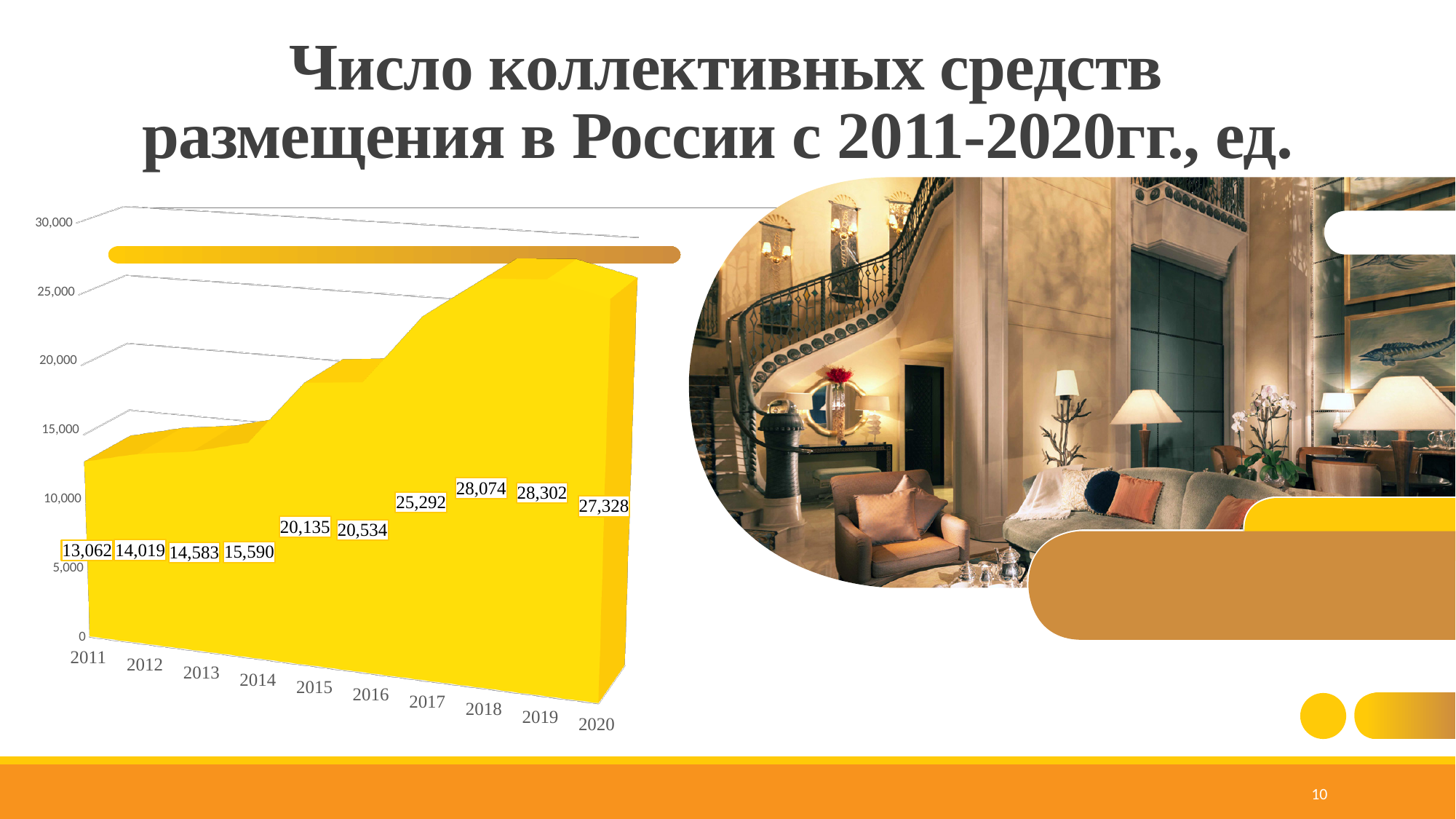
What is the value for 2020? 27,328 How many years are shown on the x axis? 10 Is the value for 2016 greater or less than 25,000? less Which is larger, the value for 2018 or the value for 2020? 2018 What is the value for 2017? 25,292 Which year has the highest value? 2019 What is the difference between the values for 2019 and 2020? 974 Which year has the lowest value? 2011 What kind of chart is shown on the slide? area chart What is the value for 2011? 13,062 Do the values generally rise or fall from 2011 to 2019? rise What is the difference between the values for 2015 and 2014? 4,545